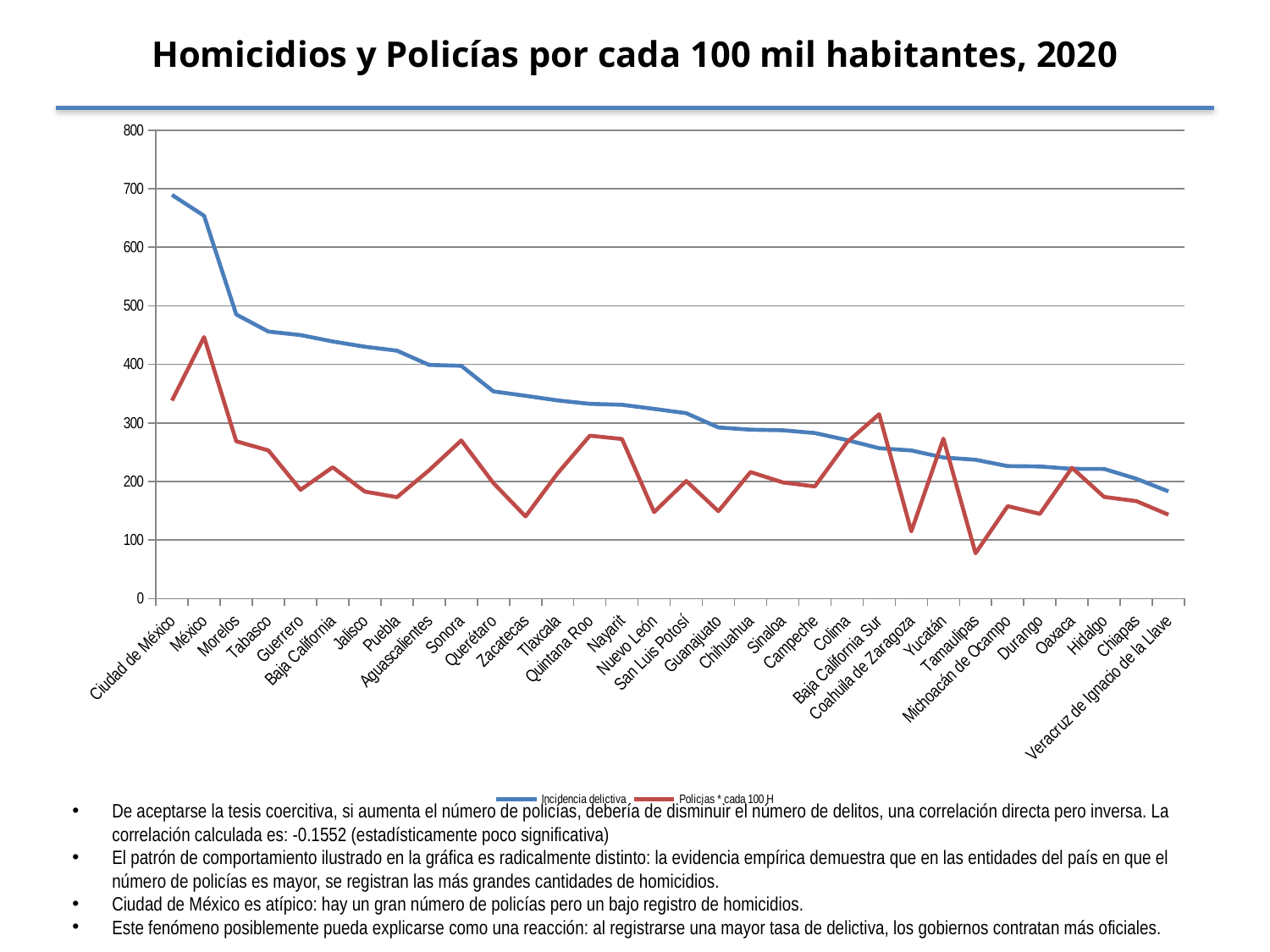
Which state has the lowest value for Incidencia delictiva? Veracruz de Ignacio de la Llave What kind of chart is shown on the slide? line chart Is the Incidencia delictiva value for Ciudad de México greater or less than 600? greater How many states (categories) are plotted along the x axis? 32 How many series does the legend list? 2 What is the title of the chart on the slide? Homicidios y Policías por cada 100 mil habitantes, 2020 Which state has the highest value for Incidencia delictiva? Ciudad de México Does the Incidencia delictiva series generally rise or fall from left to right along the x axis? fall Which state has the lowest value for Policías * cada 100 H? Tamaulipas Which state has the highest value for Policías * cada 100 H? México Is the Policías * cada 100 H value for Tamaulipas greater or less than 100? less For Baja California Sur, which series has the larger value: Incidencia delictiva or Policías * cada 100 H? Policías * cada 100 H